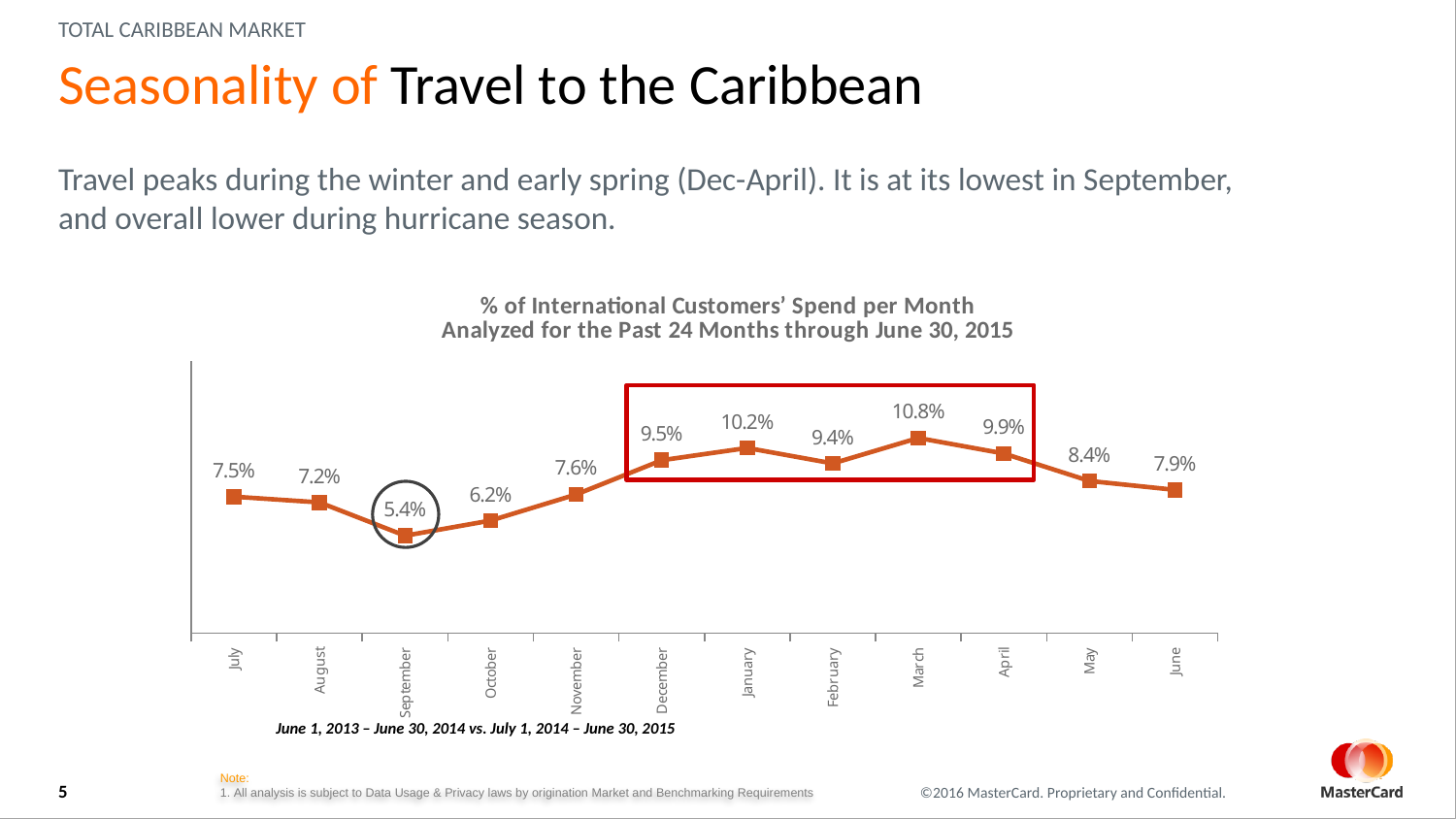
What is the difference between the values for July and June? 0.4% Which is larger, the value for December or the value for April? April What is the difference between the values for March and September? 5.4% Do the values rise or fall from September to March? Rise What is the value for January? 10.2% What is the title of the chart? % of International Customers' Spend per Month Analyzed for the Past 24 Months through June 30, 2015 Which month has the lowest value? September What is the value for March? 10.8% How many months are plotted on the chart? 12 What kind of chart is shown on the slide? Line chart What is the value for September? 5.4% Which month has the highest value? March